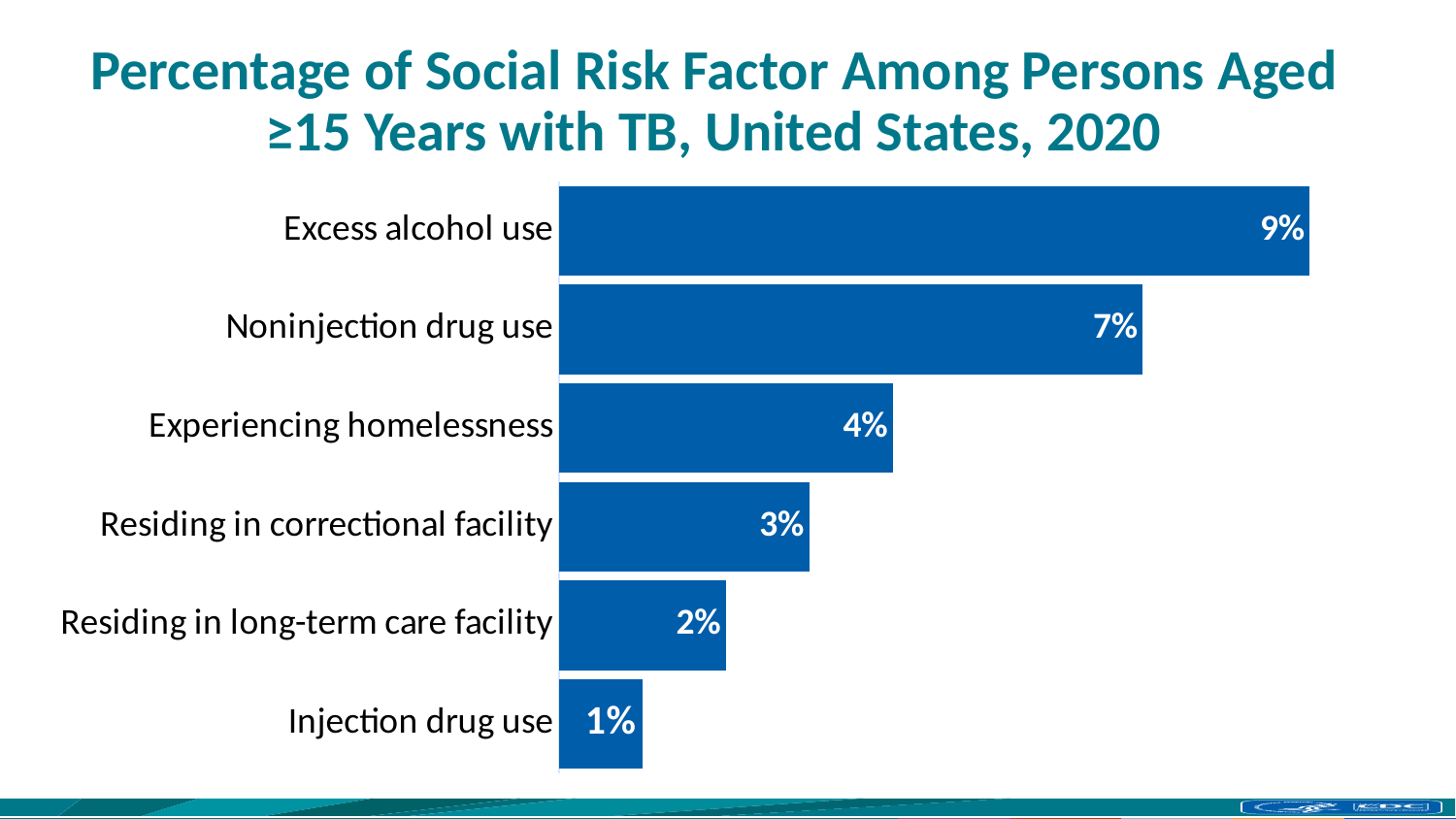
What is the difference in percentage points between Excess alcohol use and Experiencing homelessness? 5 How many social risk factors are shown in the chart? 6 What is the title of the chart? Percentage of Social Risk Factor Among Persons Aged ≥15 Years with TB, United States, 2020 What is the percentage for Residing in long-term care facility? 2% What is the percentage for Excess alcohol use? 9% What kind of chart is shown on the slide? Bar chart What is the difference in percentage points between Noninjection drug use and Injection drug use? 6 What is the percentage for Experiencing homelessness? 4% Which is larger, the percentage for Residing in correctional facility or for Residing in long-term care facility? Residing in correctional facility Which social risk factor has the highest percentage? Excess alcohol use Which social risk factor has the lowest percentage? Injection drug use What colour are the bars in the chart? Blue